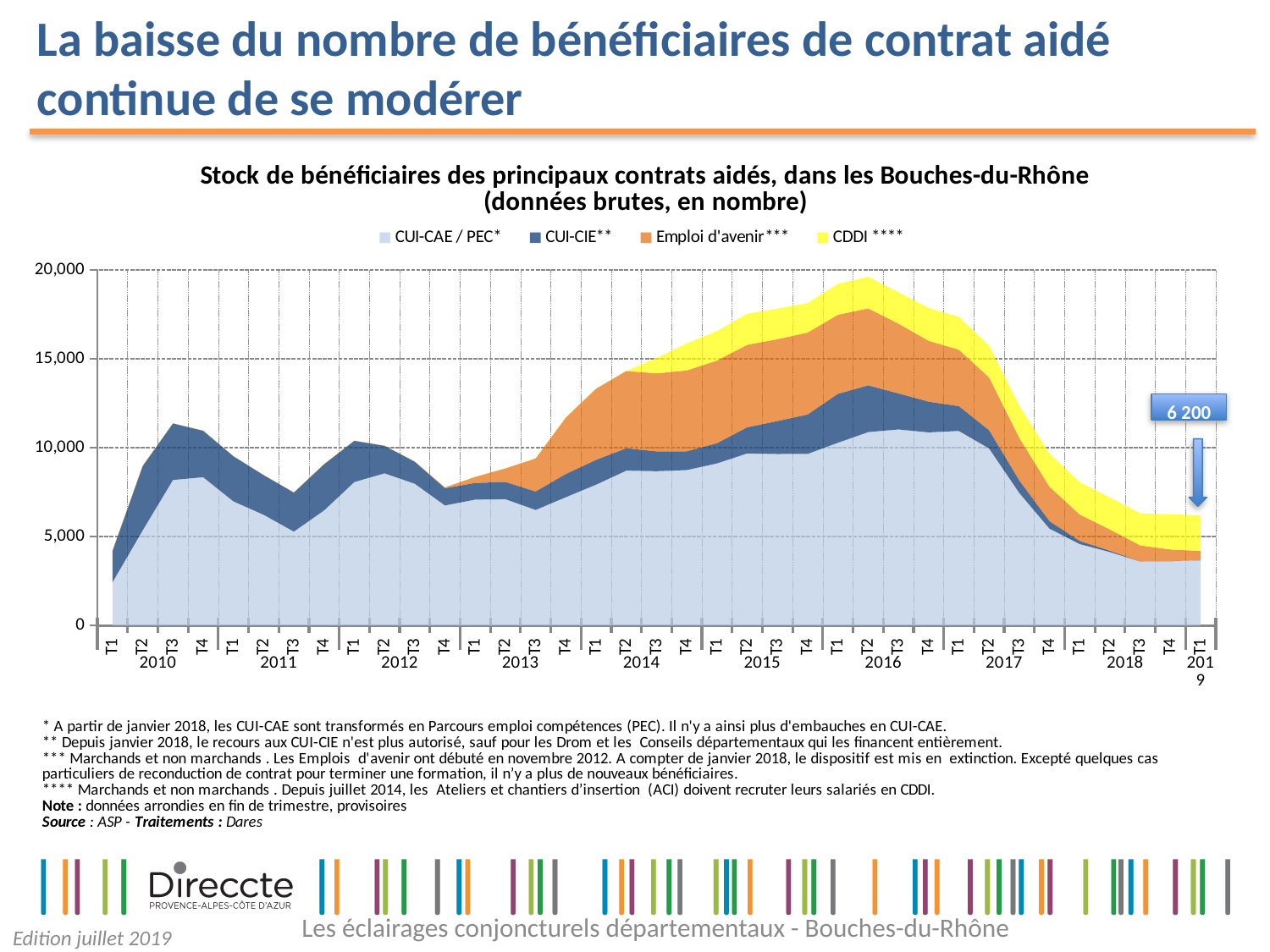
Is the total stock of beneficiaries in T1 2010 greater or less than 5,000? less What kind of chart is shown on the slide? Stacked area chart Is the total stock of beneficiaries in T1 2019 greater or less than 10,000? less Which series accounts for the largest share of beneficiaries throughout the period? CUI-CAE / PEC* Does the total stock of beneficiaries rise or fall between T2 2016 and T1 2019? Fall In which quarter does the total stock of beneficiaries reach its highest level? T2 2016 Which is larger, the total stock of beneficiaries in T2 2016 or in T1 2019? T2 2016 Is the total stock of beneficiaries in T2 2016 greater or less than 15,000? greater How many series does the chart legend list? 4 Which series is shown in yellow in the chart? CDDI **** What is the title of the chart? Stock de bénéficiaires des principaux contrats aidés, dans les Bouches-du-Rhône (données brutes, en nombre) What is the total stock of beneficiaries labelled for T1 2019? 6 200